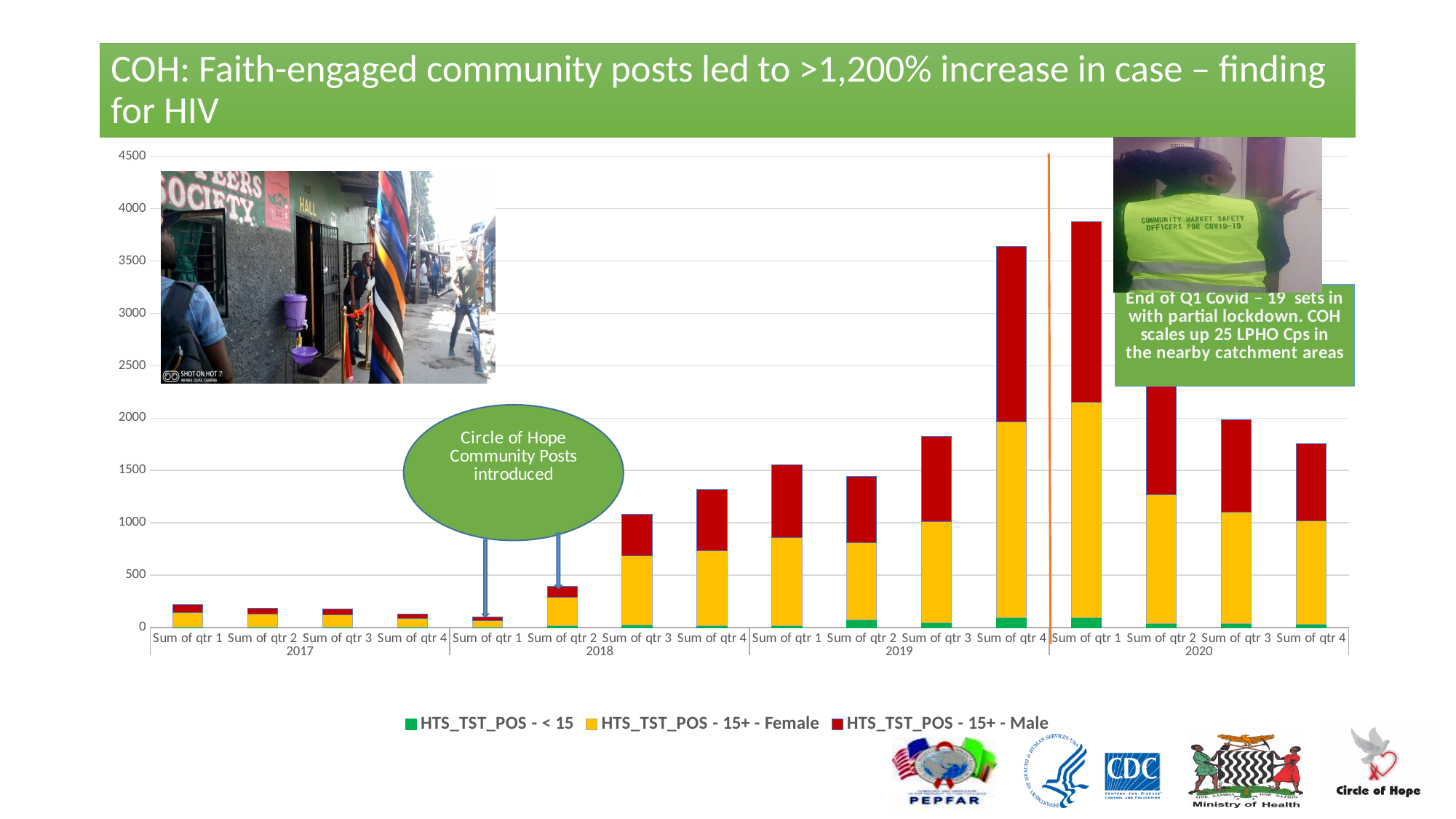
Which quarter has the shortest stacked bar? Sum of qtr 1, 2018 What kind of chart is shown on the slide? Stacked bar chart Is the total for Sum of qtr 2 in 2018 greater or less than 500? less How many series does the chart legend list? 3 How many quarterly bars are plotted in the chart? 16 According to the callout on the chart, what was introduced around qtr 1 of 2018? Circle of Hope Community Posts Is the total for Sum of qtr 4 in 2019 greater or less than 3500? greater Do the stacked bar totals rise or fall from qtr 1 to qtr 4 in 2020? fall Is the total for Sum of qtr 4 in 2020 greater or less than 1500? greater Which is larger, the total for Sum of qtr 1 in 2019 or Sum of qtr 2 in 2019? Sum of qtr 1, 2019 Which series is shown in green in the legend? HTS_TST_POS - < 15 Which quarter has the tallest stacked bar? Sum of qtr 1, 2020